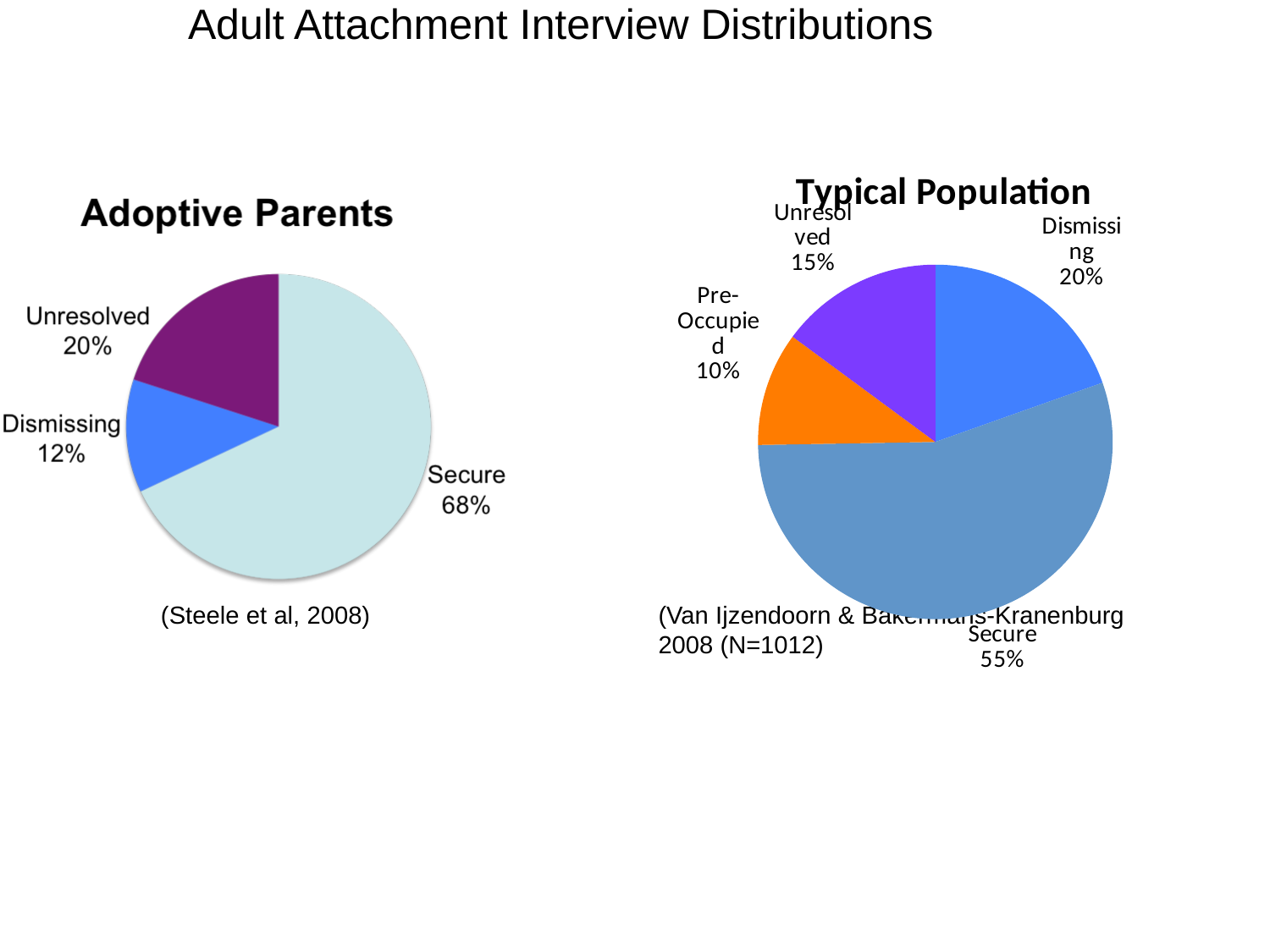
In the Adoptive Parents chart, what percentage is Secure? 68% In the Typical Population chart, which category has the largest share? Secure What type of chart is the Adoptive Parents chart? Pie chart In the Typical Population chart, what percentage is Unresolved? 15% In the Adoptive Parents chart, which category has the smallest share? Dismissing In the Typical Population chart, what percentage is Pre-Occupied? 10% Which chart shows a larger Secure share, Adoptive Parents or Typical Population? Adoptive Parents In the Adoptive Parents chart, what is the difference between the Secure and Unresolved percentages? 48% In the Typical Population chart, which category has the smallest share? Pre-Occupied How many categories are shown in the Typical Population chart? 4 In the Adoptive Parents chart, what percentage is Dismissing? 12% In the Typical Population chart, what is the difference between the Dismissing and Unresolved percentages? 5%